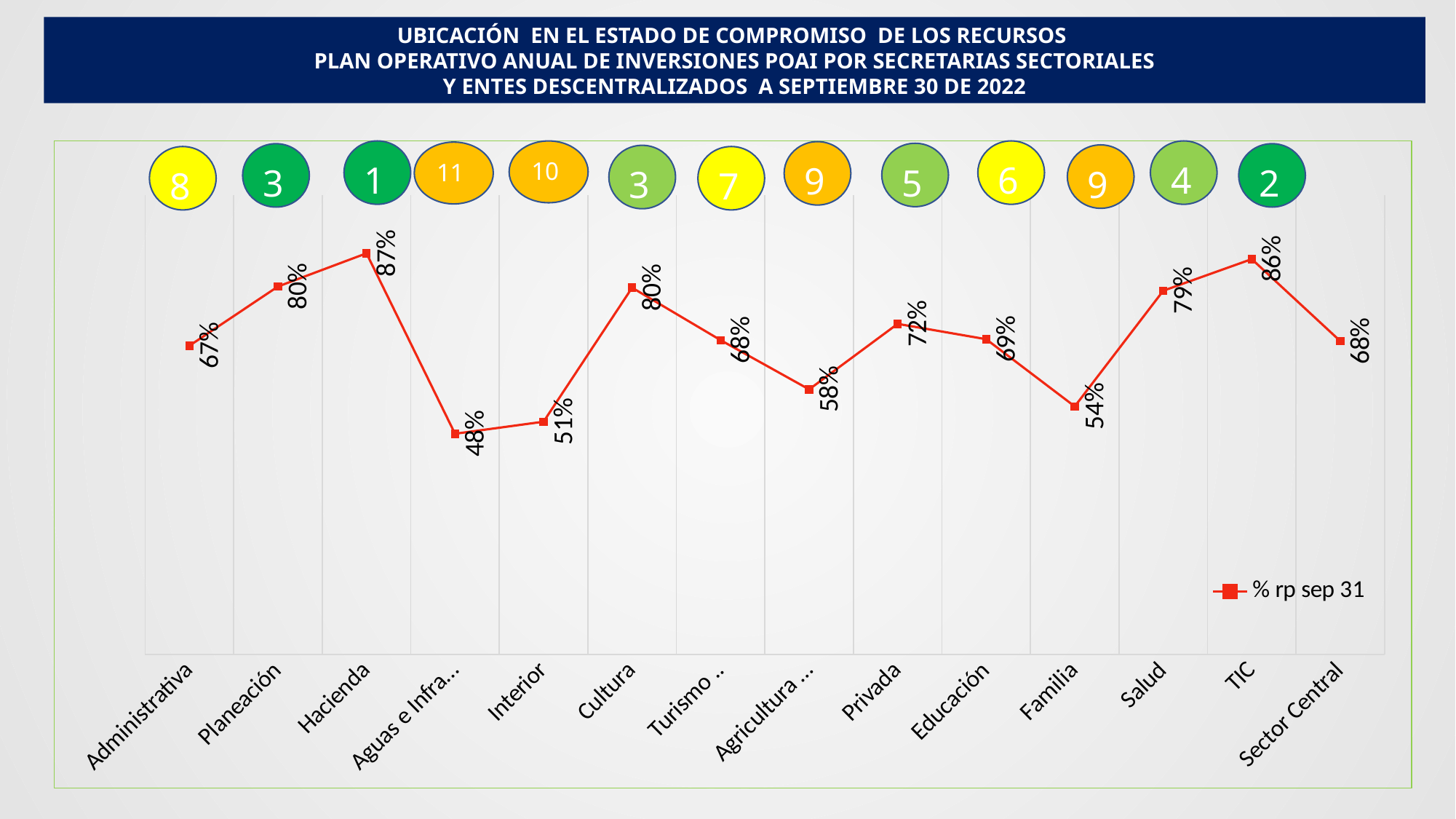
What is the value for Hacienda? 87% What is the name of the series shown in the legend? % rp sep 31 Which is larger, the value for Privada or the value for Educación? Privada What kind of chart is shown? Line chart How many categories are plotted on the x axis? 14 What is the value for Interior? 51% What is the difference between the values for Planeación and Administrativa? 13% Which category has the highest value? Hacienda What is the difference between the values for TIC and Familia? 32% What is the value for Familia? 54% What is the value for Sector Central? 68% What is the value for Salud? 79%